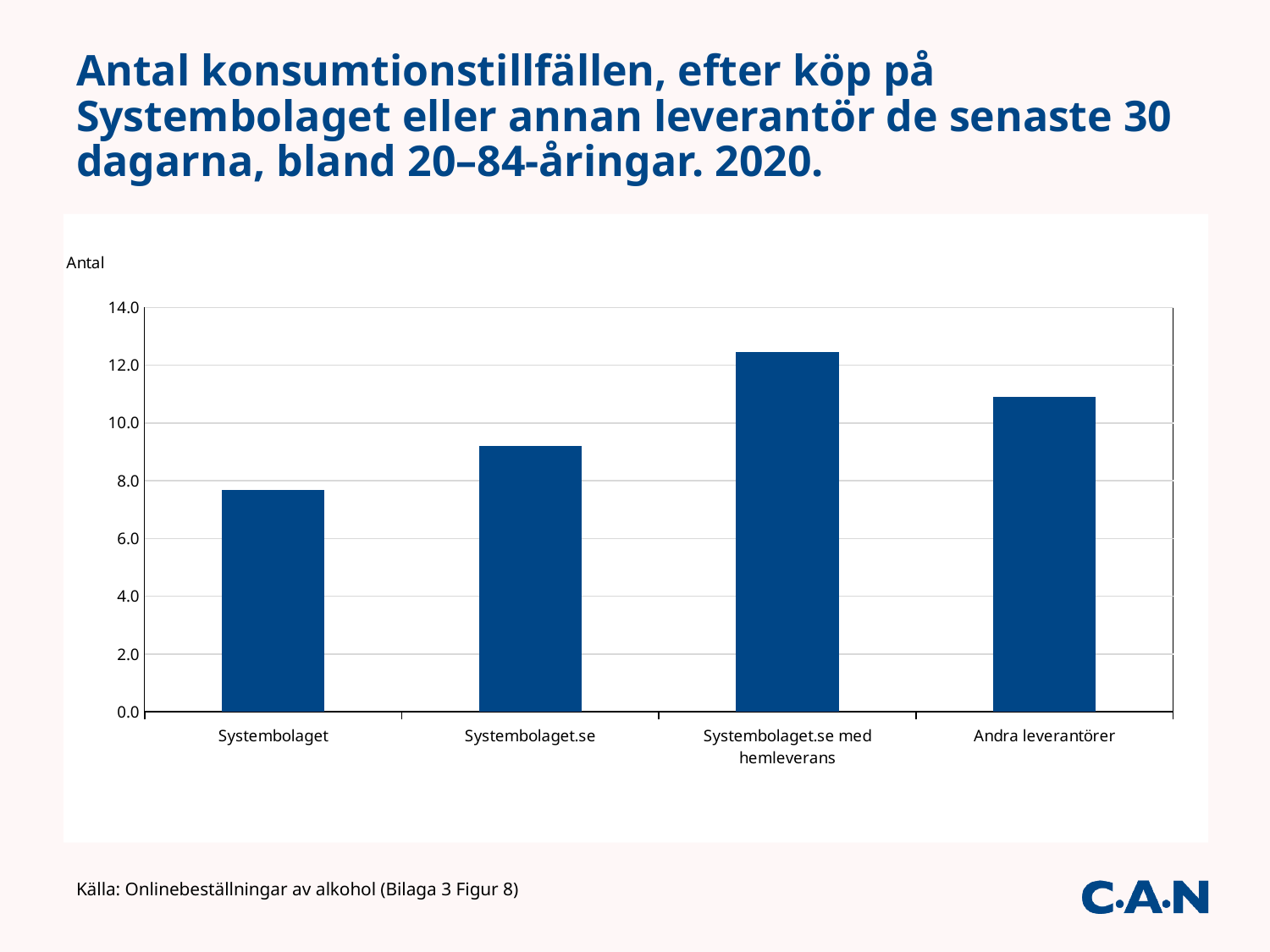
Is the value for Systembolaget.se med hemleverans greater or less than 12.0? greater Is the value for Andra leverantörer greater or less than 12.0? less Is the value for Systembolaget.se greater or less than 8.0? greater What is the label on the vertical axis of the chart? Antal What kind of chart is shown on the slide? bar chart What is the maximum value shown on the vertical axis? 14.0 Which category has the highest value? Systembolaget.se med hemleverans How many categories are shown on the x axis of the chart? 4 Which is larger, the value for Systembolaget or the value for Systembolaget.se med hemleverans? Systembolaget.se med hemleverans Which category has the lowest value? Systembolaget Which is larger, the value for Systembolaget.se or the value for Andra leverantörer? Andra leverantörer